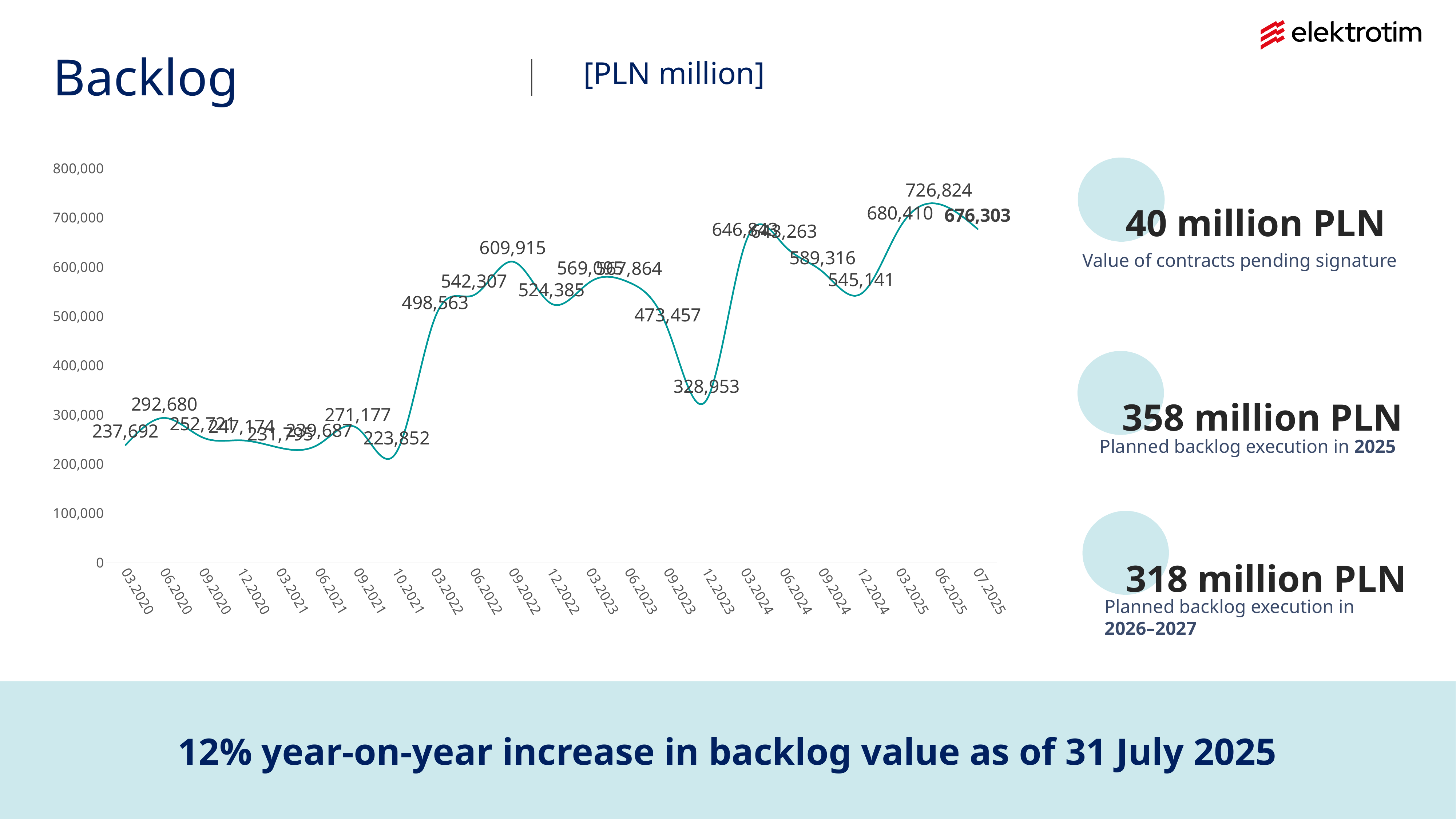
Is the backlog value for 09.2023 greater or less than 500,000? less How many periods are shown on the x axis of the chart? 23 Which period has the highest backlog value on the chart? 06.2025 What is the difference between the backlog values for 06.2025 and 07.2025? 50,521 What is the backlog value for 09.2022? 609,915 Which is larger, the backlog value for 03.2022 or for 06.2022? 06.2022 What is the highest backlog value shown on the chart? 726,824 Which period has the lowest backlog value on the chart? 10.2021 What is the backlog value for 12.2023? 328,953 Does the backlog value rise or fall from 10.2021 to 09.2022? rise What kind of chart is shown on the slide? line chart What is the backlog value for 07.2025? 676,303